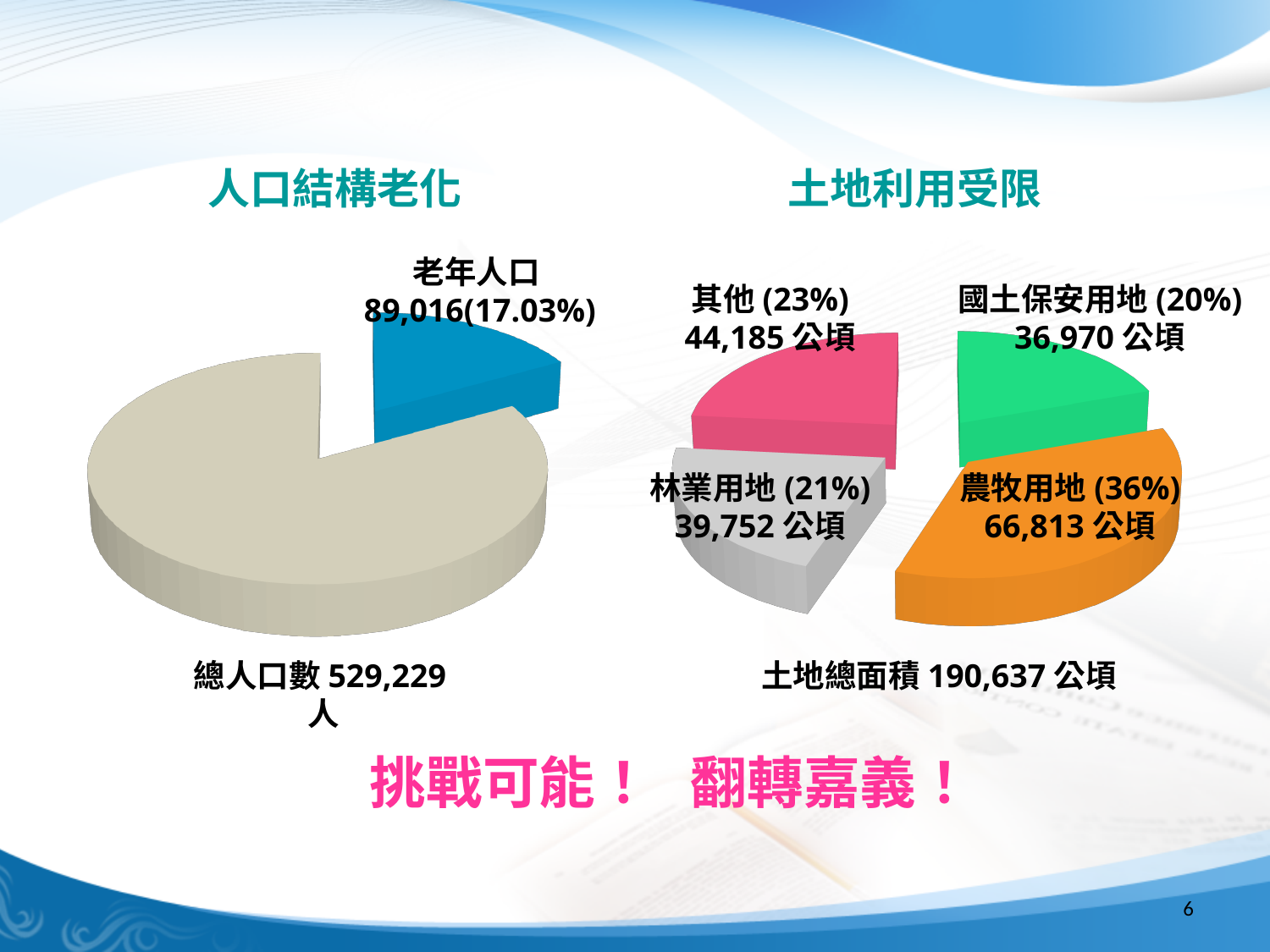
In the 土地利用受限 chart on the right, what percentage share does 國土保安用地 have? 20% In the 土地利用受限 chart on the right, what is the difference in area between 農牧用地 and 林業用地? 27,061 公頃 In the 土地利用受限 chart on the right, what percentage share does 其他 have? 23% In the 土地利用受限 chart on the right, what is the area for 林業用地? 39,752 公頃 In the 土地利用受限 chart on the right, which category has the smallest area? 國土保安用地 In the 人口結構老化 chart on the left, what is the value shown for 老年人口? 89,016(17.03%) What total land area is stated below the 土地利用受限 chart on the right? 190,637 公頃 In the 土地利用受限 chart on the right, how many slices does the pie have? 4 What kind of chart is the 人口結構老化 chart on the left? Pie chart In the 人口結構老化 chart on the left, what share of the total population is 老年人口? 17.03% In the 土地利用受限 chart on the right, which category has the largest area? 農牧用地 In the 土地利用受限 chart on the right, what is the area for 農牧用地? 66,813 公頃